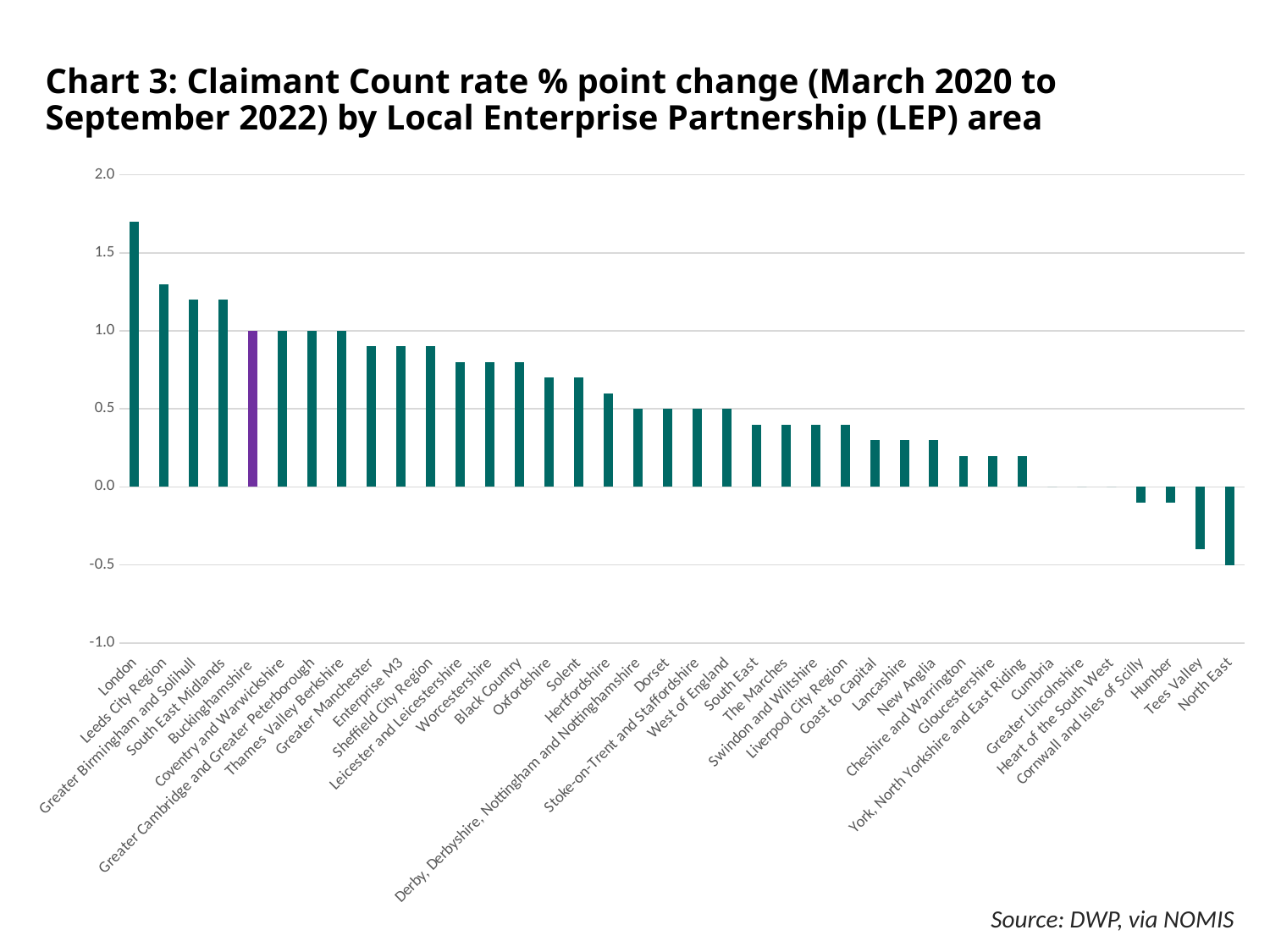
What is the Claimant Count rate percentage point change for West of England? 0.5 Which LEP area has the highest Claimant Count rate percentage point change? London Which LEP area has the lowest Claimant Count rate percentage point change? North East Which has a larger Claimant Count rate percentage point change, London or Leeds City Region? London What is the Claimant Count rate percentage point change for Buckinghamshire? 1.0 Is the value for London greater or less than 1.5? greater Which LEP area's bar is coloured purple rather than green? Buckinghamshire What is the Claimant Count rate percentage point change for North East? -0.5 Is the value for Tees Valley greater or less than 0.0? less Do the values generally rise or fall moving from left to right along the x axis? Fall What type of chart is shown on the slide? Bar chart Is the value for Greater Manchester greater or less than 1.0? less